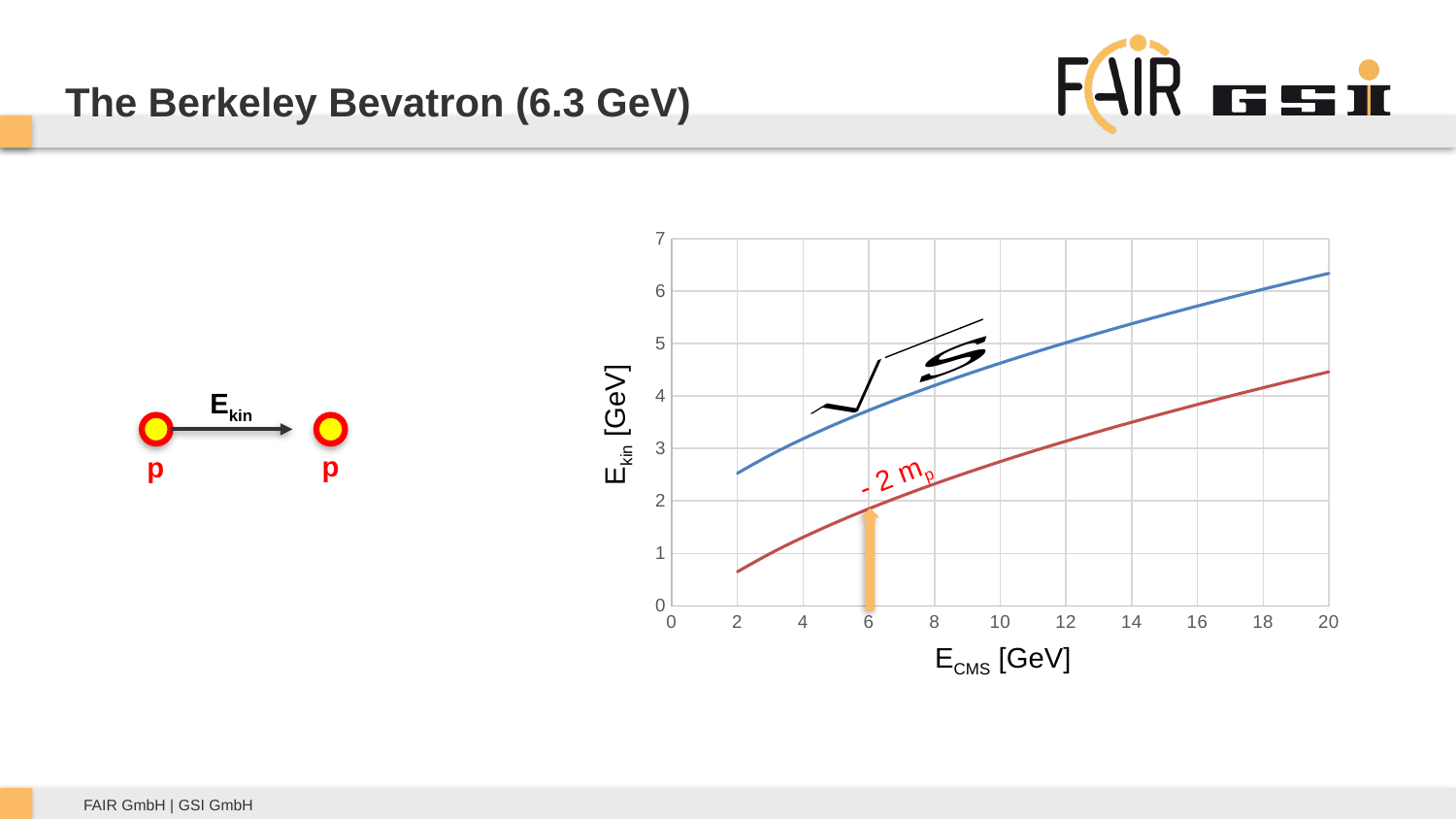
How many curves are plotted on the chart? 2 Is the value of the blue curve at E_CMS = 20 GeV greater or less than 6? greater Is the value of the red curve at E_CMS = 2 GeV greater or less than 1? less What kind of chart is shown on the slide? line chart What is the label of the x axis of the chart? E_CMS [GeV] Which curve has the larger E_kin value at E_CMS = 10 GeV, the blue one or the red one? the blue one Is the value of the red curve at E_CMS = 6 GeV greater or less than 2? less At which E_CMS value does the orange arrow on the chart point? 6 Do the values of the red curve rise or fall as E_CMS increases? rise Do the values of the blue curve rise or fall as E_CMS increases? rise